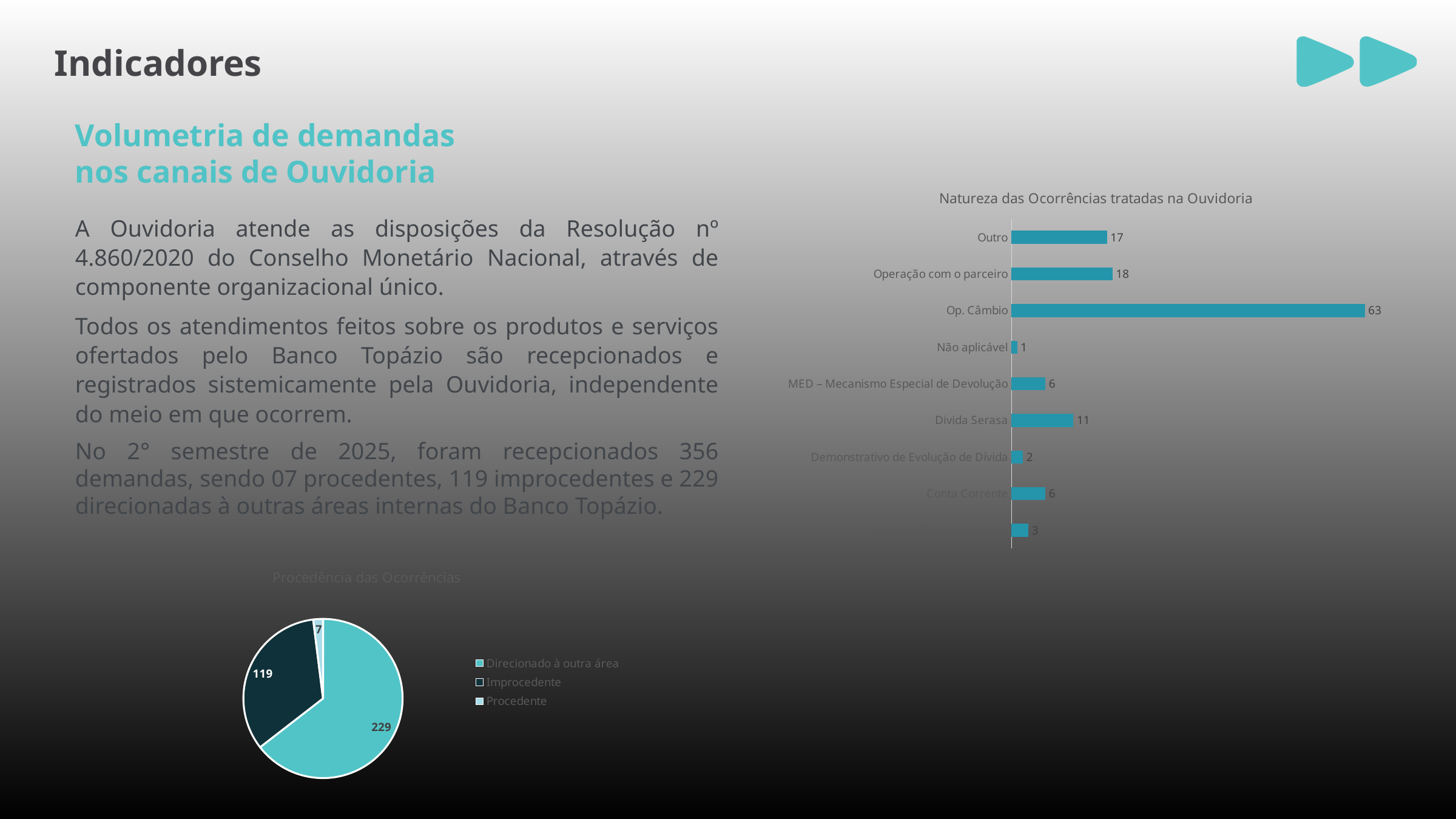
In the pie chart 'Procedência das Ocorrências', which slice is the largest? Direcionado à outra área In the pie chart 'Procedência das Ocorrências', what is the value for Procedente? 7 In the chart 'Natureza das Ocorrências tratadas na Ouvidoria', which is larger: Outro or Operação com o parceiro? Operação com o parceiro In the chart 'Natureza das Ocorrências tratadas na Ouvidoria', which category has the highest value? Op. Câmbio What kind of chart is 'Natureza das Ocorrências tratadas na Ouvidoria'? Bar chart In the chart 'Natureza das Ocorrências tratadas na Ouvidoria', what is the difference between Op. Câmbio and Outro? 46 In the chart 'Natureza das Ocorrências tratadas na Ouvidoria', what is the value for Operação com o parceiro? 18 In the chart 'Natureza das Ocorrências tratadas na Ouvidoria', which category has the lowest value? Não aplicável In the chart 'Natureza das Ocorrências tratadas na Ouvidoria', what is the value for Dívida Serasa? 11 In the pie chart 'Procedência das Ocorrências', what is the value for Improcedente? 119 In the chart 'Natureza das Ocorrências tratadas na Ouvidoria', what is the value for Op. Câmbio? 63 How many entries does the legend of the pie chart 'Procedência das Ocorrências' list? 3